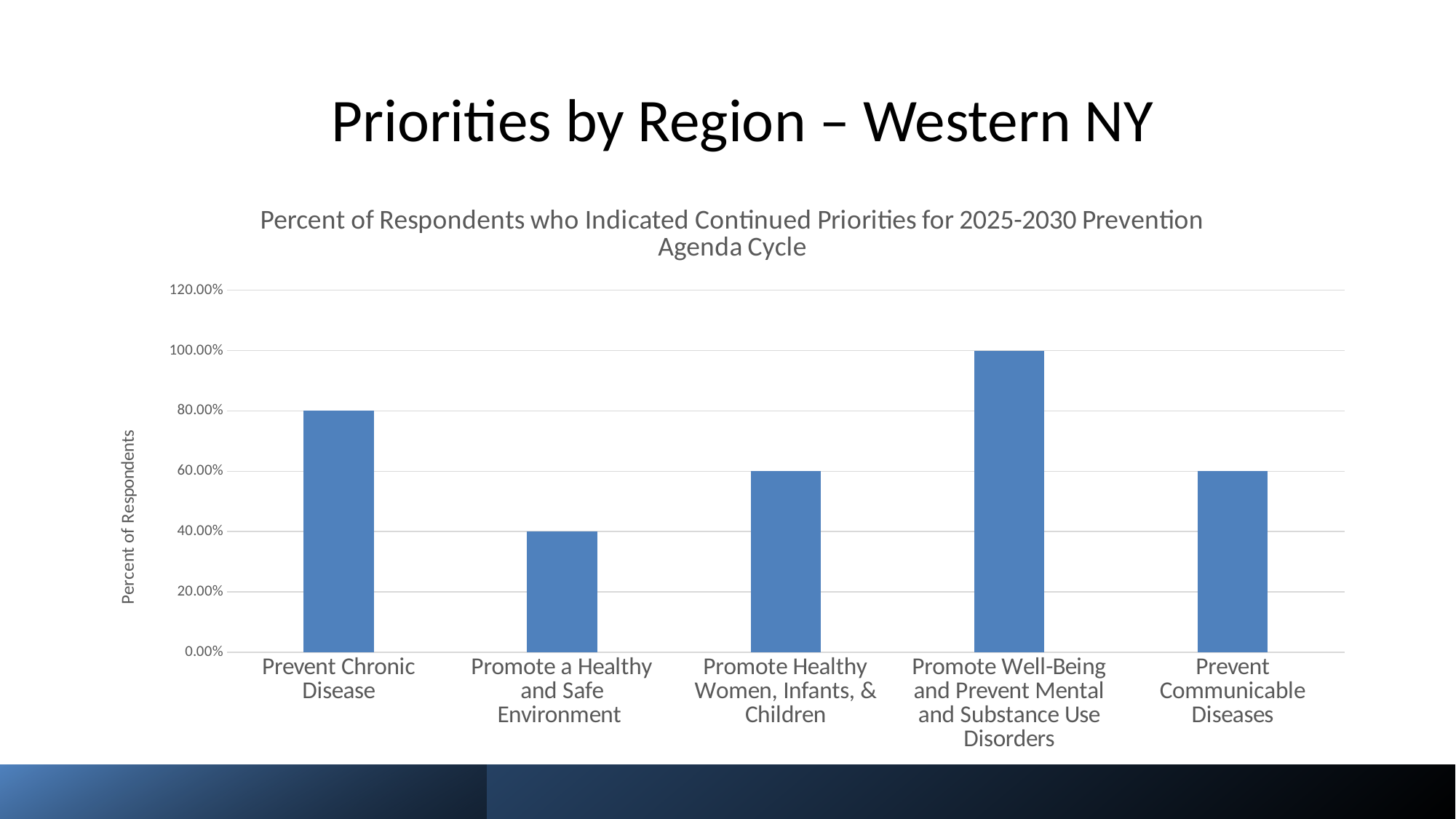
What is the value for Promote a Healthy and Safe Environment? 40.00% What kind of chart is shown on the slide? bar chart What is the value for Prevent Communicable Diseases? 60.00% How many categories are shown on the x axis? 5 What is the label of the vertical axis? Percent of Respondents What is the value for Promote Well-Being and Prevent Mental and Substance Use Disorders? 100.00% What is the value for Prevent Chronic Disease? 80.00% Which is larger, the value for Prevent Chronic Disease or the value for Promote Healthy Women, Infants, & Children? Prevent Chronic Disease What is the difference between the values for Prevent Chronic Disease and Promote a Healthy and Safe Environment? 40.00% Which category has the lowest percent of respondents? Promote a Healthy and Safe Environment Which category has the highest percent of respondents? Promote Well-Being and Prevent Mental and Substance Use Disorders Is the value for Promote Healthy Women, Infants, & Children greater or less than 80.00%? less